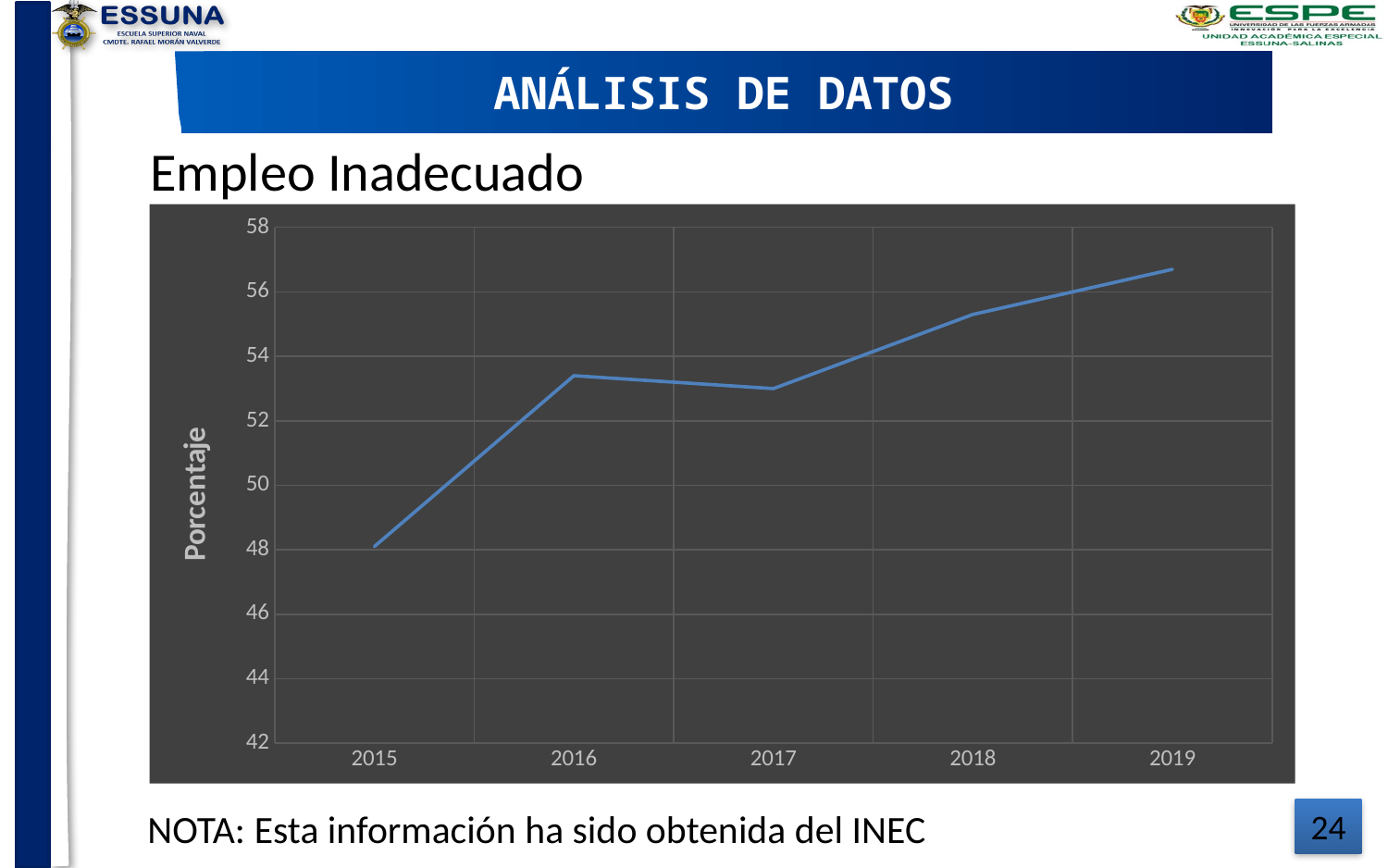
Is the value for 2019 greater or less than 56? greater What is the label of the vertical axis? Porcentaje Which year has the lowest value? 2015 How many years are plotted on the x axis? 5 Overall, do the values rise or fall from 2015 to 2019? rise What is the title of the chart? Empleo Inadecuado Is the value for 2016 greater or less than 52? greater What kind of chart is shown on the slide? line chart Is the value for 2018 greater or less than 54? greater Which year has the highest value? 2019 Which is larger, the value for 2015 or the value for 2018? 2018